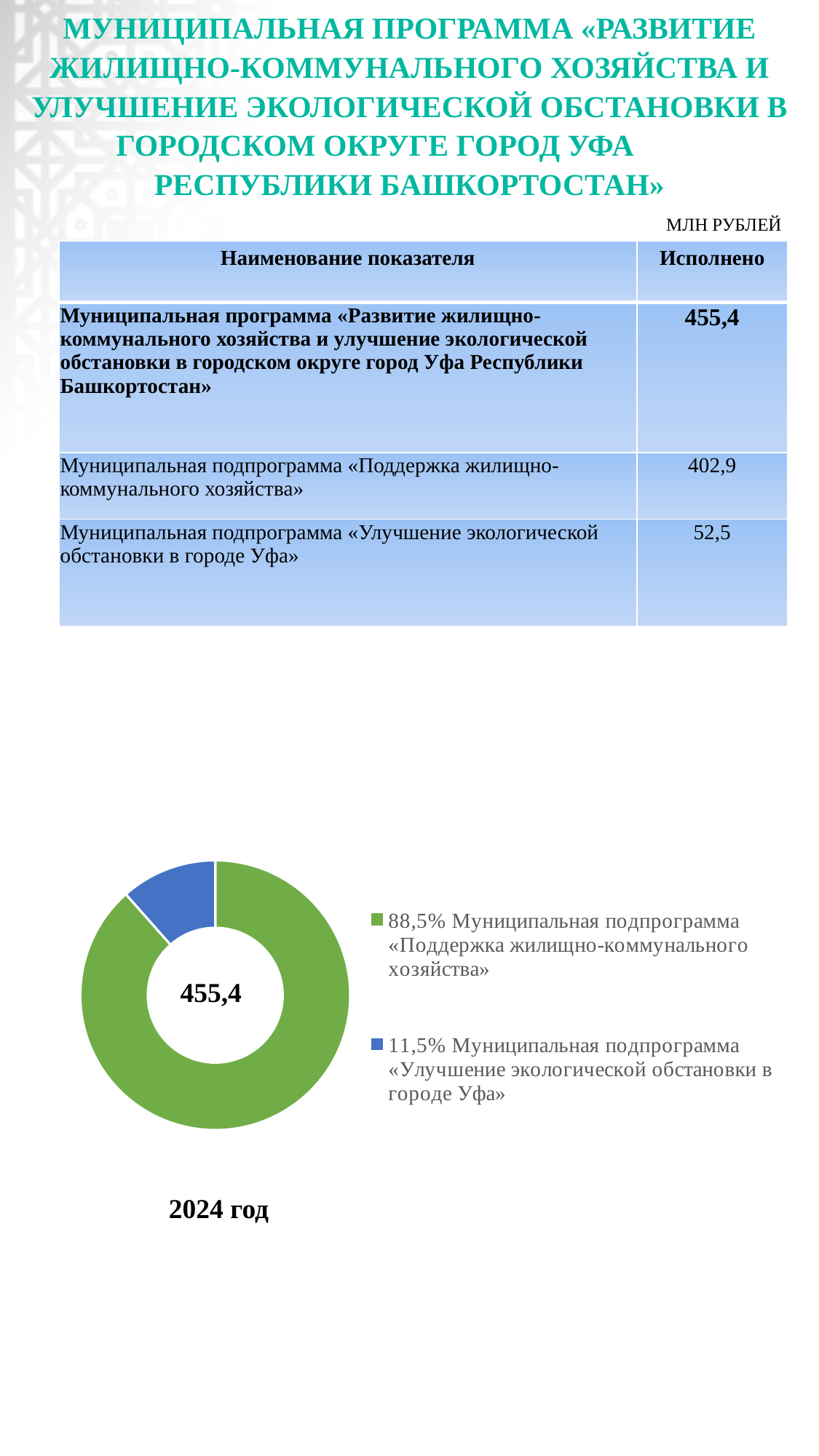
Which slice of the doughnut chart is the smallest? Муниципальная подпрограмма «Улучшение экологической обстановки в городе Уфа» What kind of chart is shown on the slide? Doughnut (pie) chart What share of the doughnut chart does the subprogramme «Поддержка жилищно-коммунального хозяйства» take? 88,5% Which slice of the doughnut chart is the largest? Муниципальная подпрограмма «Поддержка жилищно-коммунального хозяйства» By how many percentage points does the share of «Поддержка жилищно-коммунального хозяйства» exceed the share of «Улучшение экологической обстановки в городе Уфа» in the doughnut chart? 77 percentage points Which is larger in the doughnut chart: the share of «Поддержка жилищно-коммунального хозяйства» or the share of «Улучшение экологической обстановки в городе Уфа»? «Поддержка жилищно-коммунального хозяйства» What share of the doughnut chart does the subprogramme «Улучшение экологической обстановки в городе Уфа» take? 11,5% What year label is shown below the doughnut chart? 2024 год What value is printed in the centre of the doughnut chart? 455,4 How many slices does the doughnut chart have? 2 How many entries does the legend of the doughnut chart list? 2 What colour is the slice for «Улучшение экологической обстановки в городе Уфа» in the doughnut chart? Blue